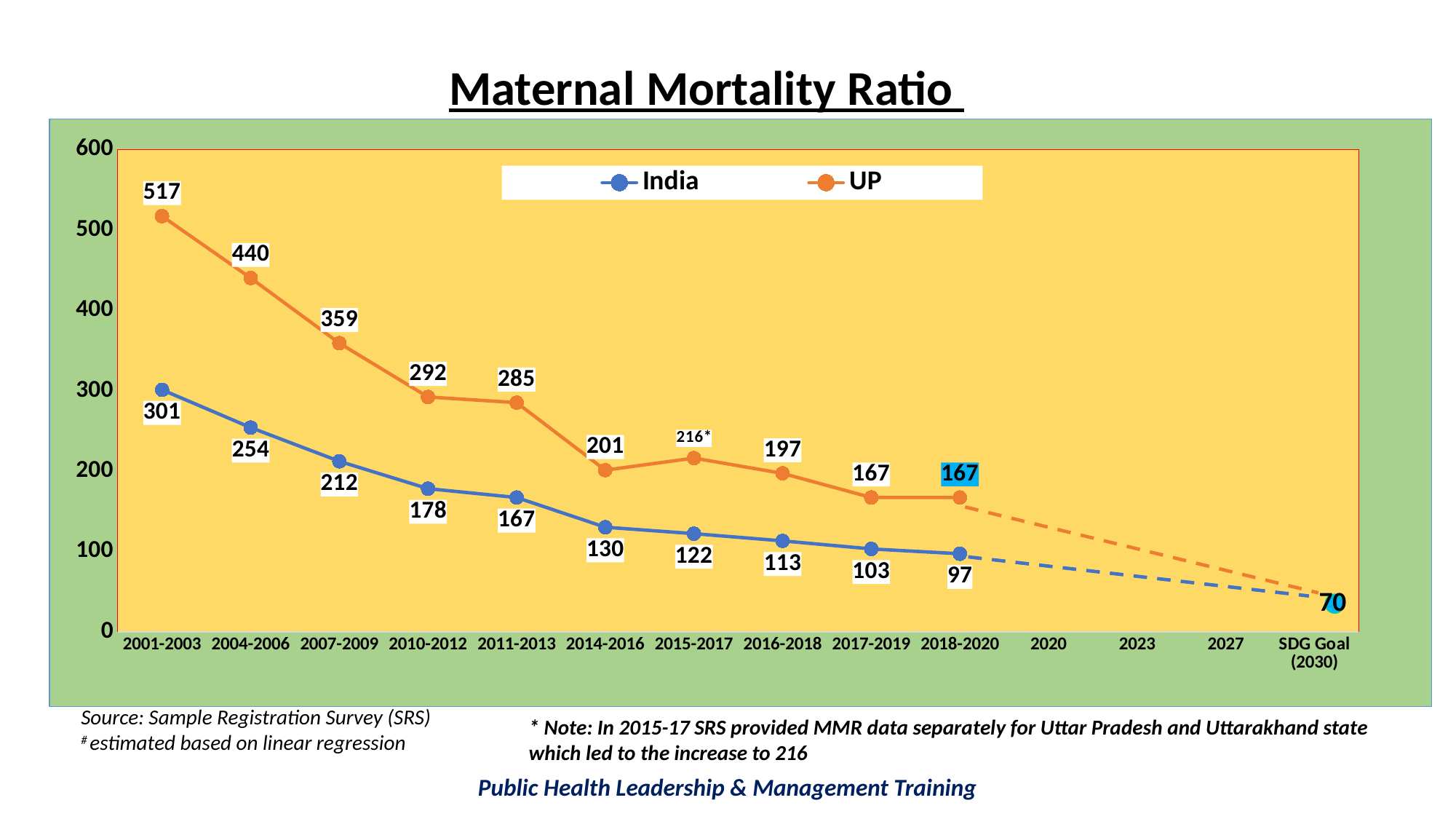
Which is larger in 2014-2016, the India value or the UP value? UP Do the India values rise or fall from 2001-2003 to 2018-2020? Fall Is the UP value for 2007-2009 greater or less than 300? greater What is the UP value for 2015-2017? 216 What is the difference between the UP and India values for 2001-2003? 216 What is the India value for 2010-2012? 178 What is the India value for 2018-2020? 97 How many series does the legend list? 2 Which period has the lowest India value? 2018-2020 What kind of chart is shown? Line chart What is the UP value for 2001-2003? 517 Which period has the highest UP value? 2001-2003